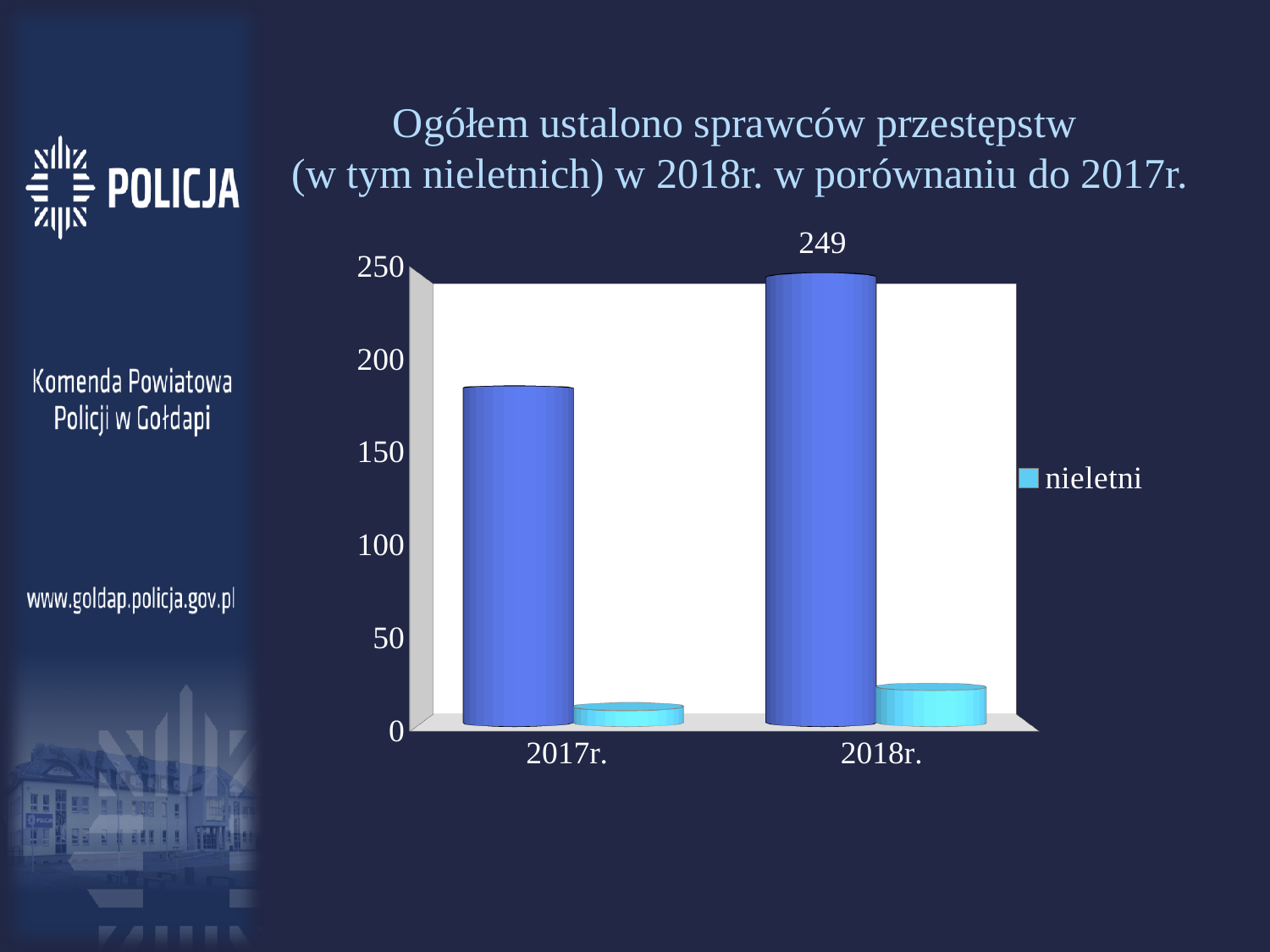
What kind of chart is shown on the slide? bar chart Which year has the highest value for the taller (dark blue) bar? 2018r. Which year has the higher value for the taller (dark blue) bar, 2017r. or 2018r.? 2018r. Is the value of the 'nieletni' bar for 2018r. greater or less than 50? less How many categories (years) are shown on the x axis? 2 What is the series name shown in the legend? nieletni How many series does the legend list? 1 Is the value of the taller (dark blue) bar for 2017r. greater or less than 200? less Is the value of the taller (dark blue) bar for 2017r. greater or less than 150? greater Do the values of the taller (dark blue) bars rise or fall from 2017r. to 2018r.? rise What is the value shown for the taller bar in 2018r.? 249 Which year has the higher 'nieletni' value, 2017r. or 2018r.? 2018r.